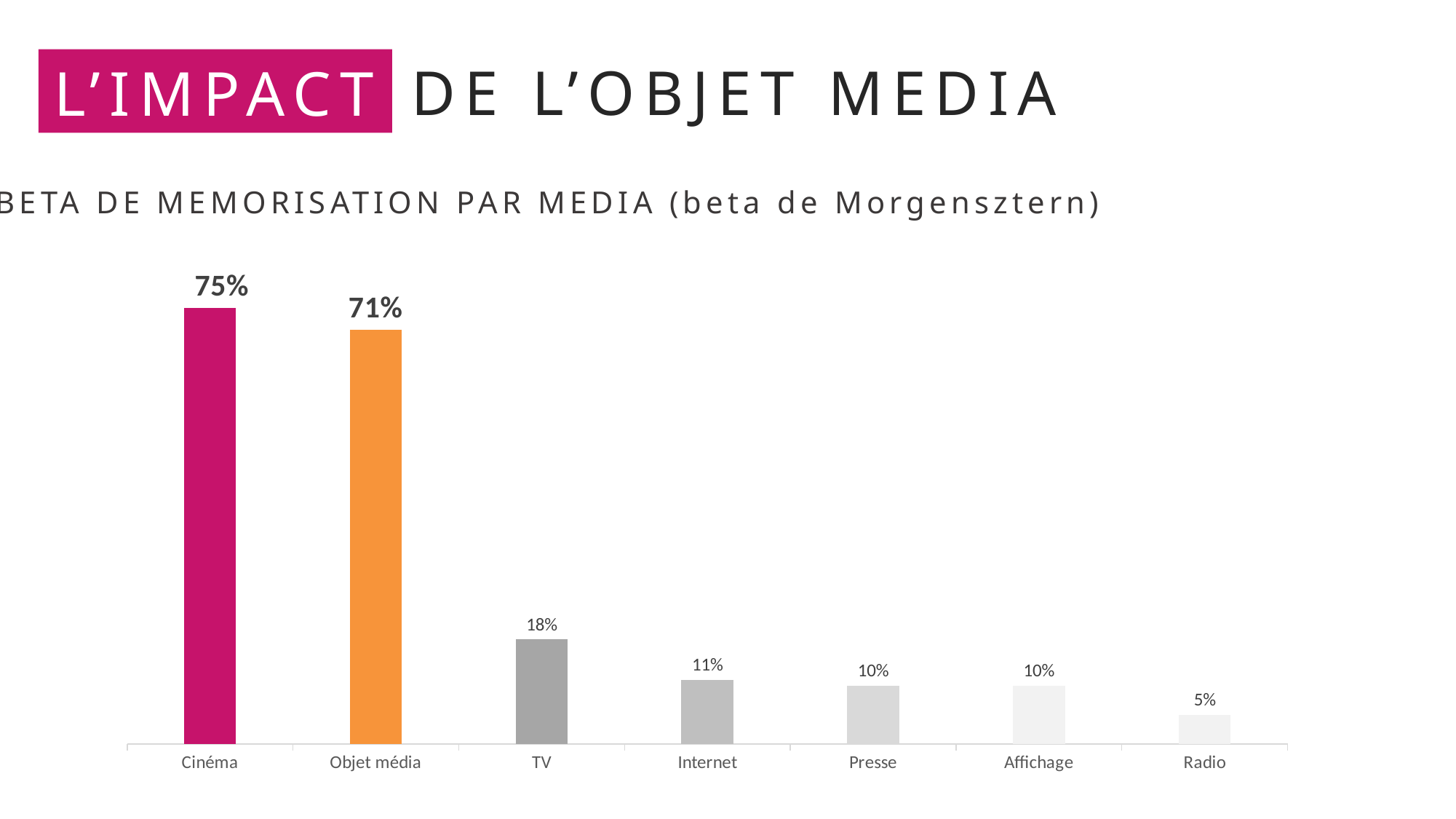
What is the value for TV? 18% Which category has the lowest value? Radio What kind of chart is shown on the slide? Bar chart What is the value for Objet média? 71% What is the value for Radio? 5% What is the value for Cinéma? 75% Which is larger, the value for Internet or the value for Radio? Internet How many categories are shown on the x axis? 7 Which category's bar is coloured orange? Objet média Which category has the highest value? Cinéma What is the difference between the values for Cinéma and Objet média? 4% What is the difference between the values for TV and Internet? 7%